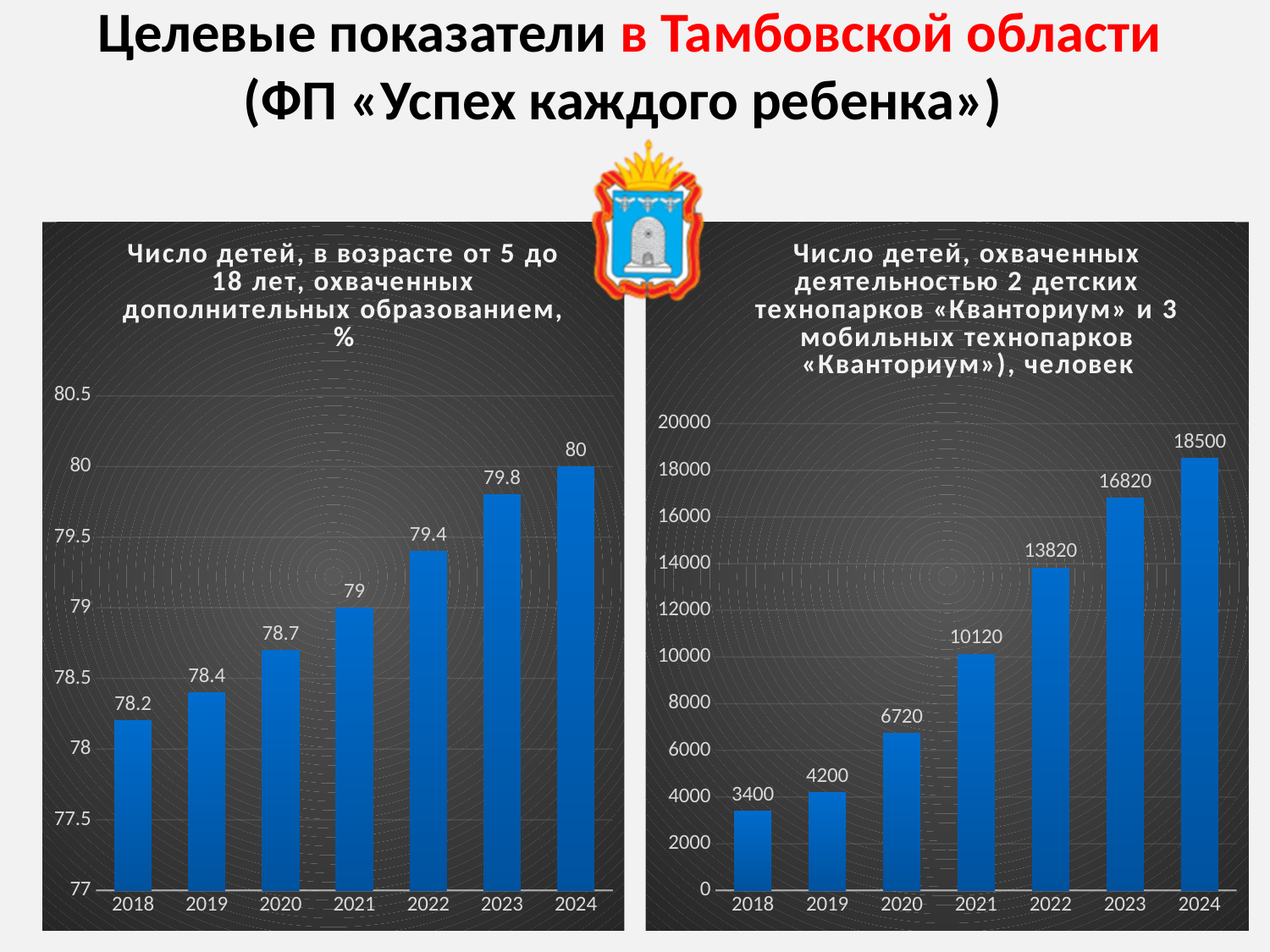
In the left chart (Число детей, в возрасте от 5 до 18 лет, охваченных дополнительных образованием, %), do the values rise or fall from 2018 to 2024? rise In the right chart (Число детей, охваченных деятельностью 2 детских технопарков «Кванториум»...), what is the value for 2022? 13820 In the right chart (Число детей, охваченных деятельностью 2 детских технопарков «Кванториум»...), what is the difference between the values for 2024 and 2023? 1680 In the right chart (Число детей, охваченных деятельностью 2 детских технопарков «Кванториум»...), what is the value for 2019? 4200 In the right chart (Число детей, охваченных деятельностью 2 детских технопарков «Кванториум»...), which year has the lowest value? 2018 How many years are shown on the x axis of the right chart (Число детей, охваченных деятельностью 2 детских технопарков «Кванториум»...)? 7 In the left chart (Число детей, в возрасте от 5 до 18 лет, охваченных дополнительных образованием, %), which year has the highest value? 2024 In the left chart (Число детей, в возрасте от 5 до 18 лет, охваченных дополнительных образованием, %), what is the value for 2018? 78.2 In the right chart (Число детей, охваченных деятельностью 2 детских технопарков «Кванториум»...), which is larger, the value for 2020 or the value for 2021? 2021 In the left chart (Число детей, в возрасте от 5 до 18 лет, охваченных дополнительных образованием, %), what is the value for 2021? 79 What type of chart is the left chart (Число детей, в возрасте от 5 до 18 лет, охваченных дополнительных образованием, %)? bar chart In the left chart (Число детей, в возрасте от 5 до 18 лет, охваченных дополнительных образованием, %), what is the difference between the values for 2024 and 2018? 1.8